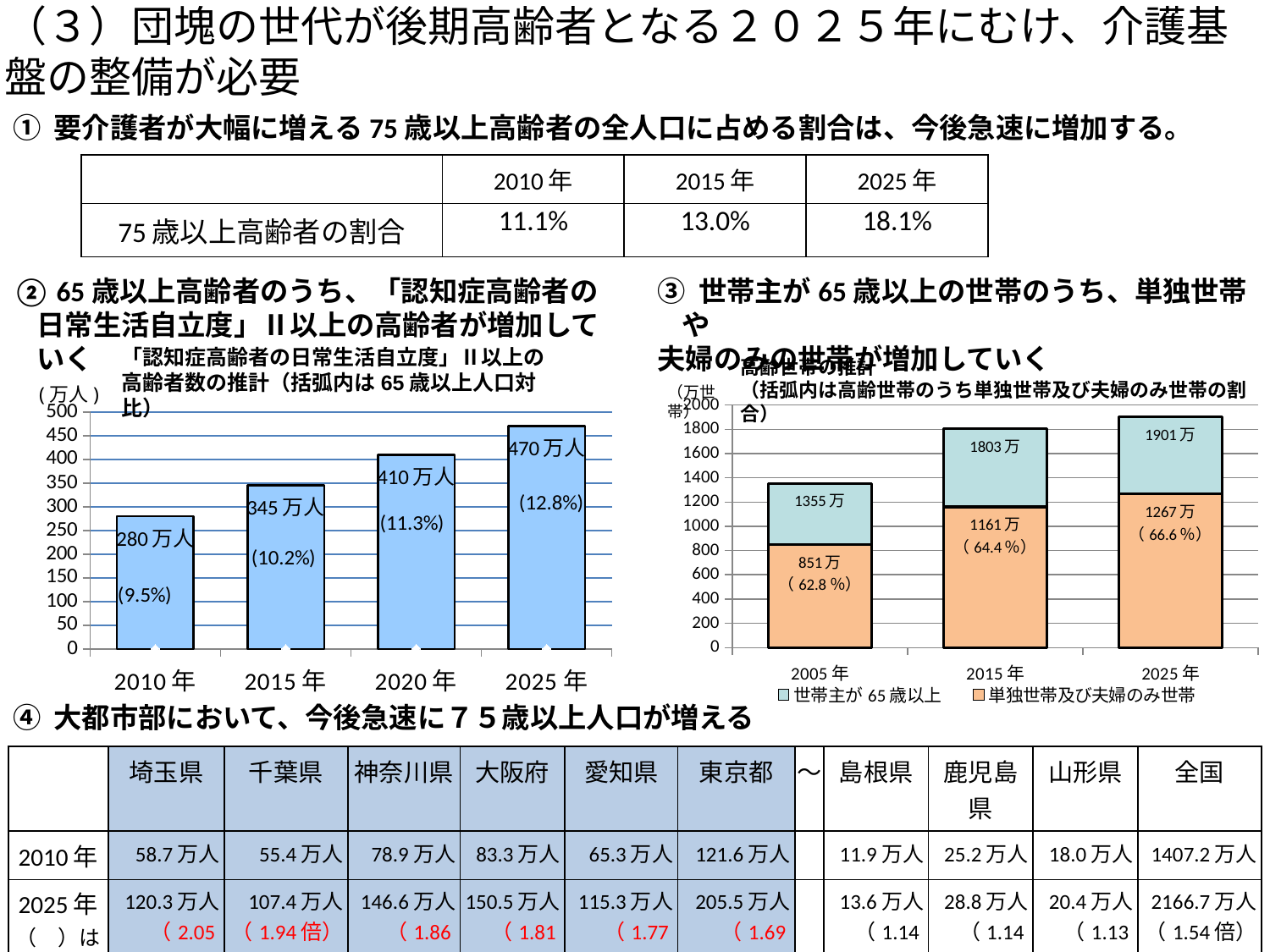
In the right chart, what is the value for 世帯主が65歳以上 in 2025年? 1901万 In the left bar chart, what is the difference between the values for 2025年 and 2010年? 190万人 In the right chart, what is the value for 単独世帯及び夫婦のみ世帯 in 2015年? 1161万 In the left bar chart, what is the value for 2010年? 280万人 In the right chart, what percentage is shown in parentheses for 単独世帯及び夫婦のみ世帯 in 2005年? 62.8% In the left bar chart, how many years are plotted? 4 In the left bar chart, what percentage is shown in parentheses for 2025年? 12.8% In the left bar chart, which year has the highest value? 2025年 In the left bar chart, which year has the lowest value? 2010年 In the left bar chart, do the values rise or fall from 2010年 to 2025年? rise In the right chart, which is larger: 世帯主が65歳以上 in 2015年 or in 2005年? 2015年 In the right chart, how many series does the legend list? 2